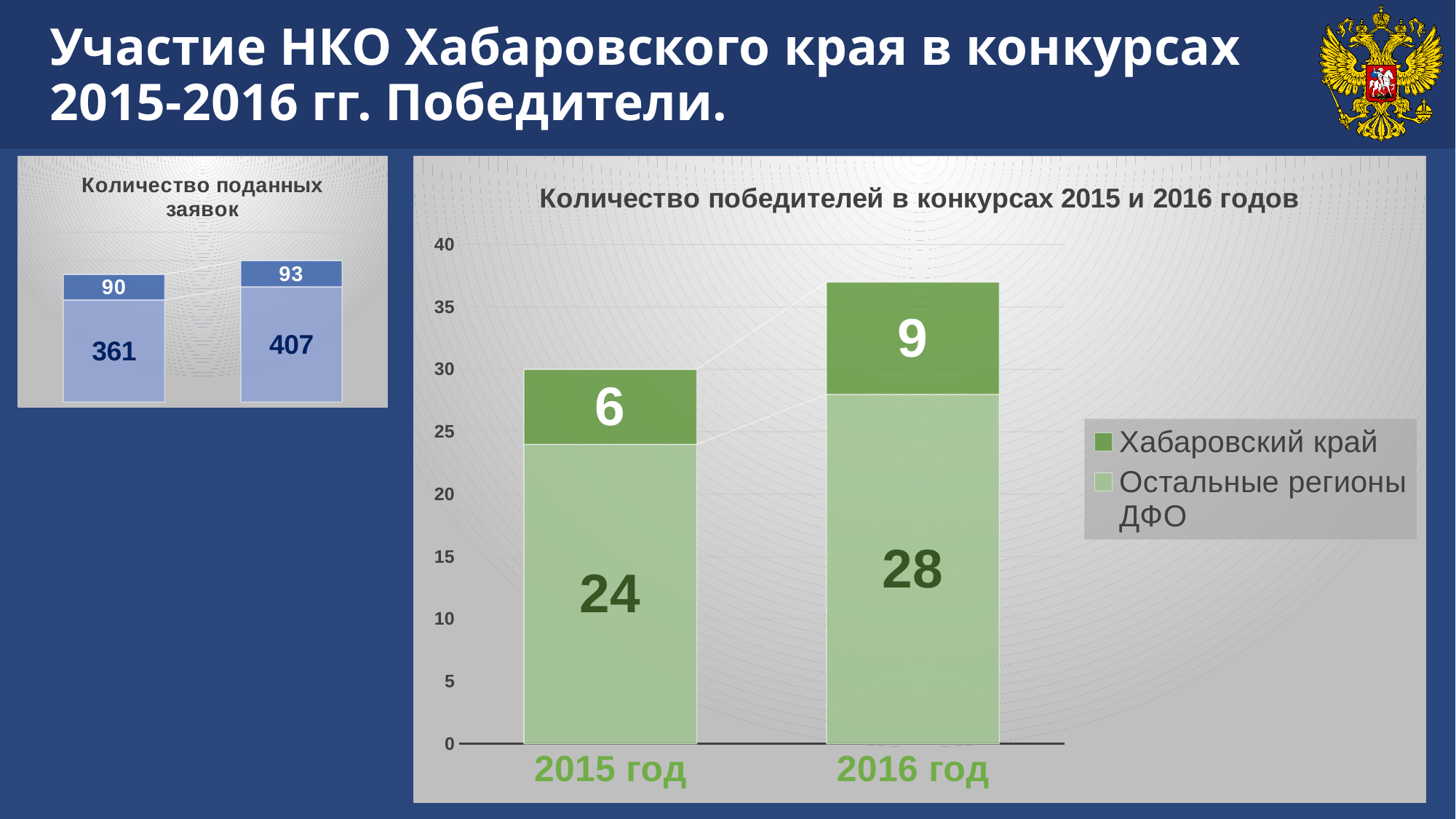
In the chart titled "Количество победителей в конкурсах 2015 и 2016 годов", by how much did the number of winners from Хабаровский край increase from 2015 год to 2016 год? 3 In the chart titled "Количество победителей в конкурсах 2015 и 2016 годов", how many winners from Остальные регионы ДФО were there in 2016 год? 28 In the chart titled "Количество победителей в конкурсах 2015 и 2016 годов", what is the total height of the stacked bar for 2015 год? 30 In the chart titled "Количество поданных заявок" on the left, what is the total of the left-hand stacked bar (90 and 361)? 451 In the chart titled "Количество победителей в конкурсах 2015 и 2016 годов", does the total number of winners rise or fall from 2015 год to 2016 год? rise In the chart titled "Количество победителей в конкурсах 2015 и 2016 годов", how many series does the legend list? 2 What kind of chart is the one titled "Количество победителей в конкурсах 2015 и 2016 годов"? stacked bar chart In the chart titled "Количество победителей в конкурсах 2015 и 2016 годов", how many winners from Хабаровский край were there in 2015 год? 6 In the chart titled "Количество победителей в конкурсах 2015 и 2016 годов", which year has the higher total number of winners? 2016 год In the chart titled "Количество поданных заявок" on the left, what is the value of the larger (lower) segment of the right-hand bar? 407 In the chart titled "Количество победителей в конкурсах 2015 и 2016 годов", which legend entry is shown in the darker green colour? Хабаровский край In the chart titled "Количество победителей в конкурсах 2015 и 2016 годов", what is the total height of the stacked bar for 2016 год? 37